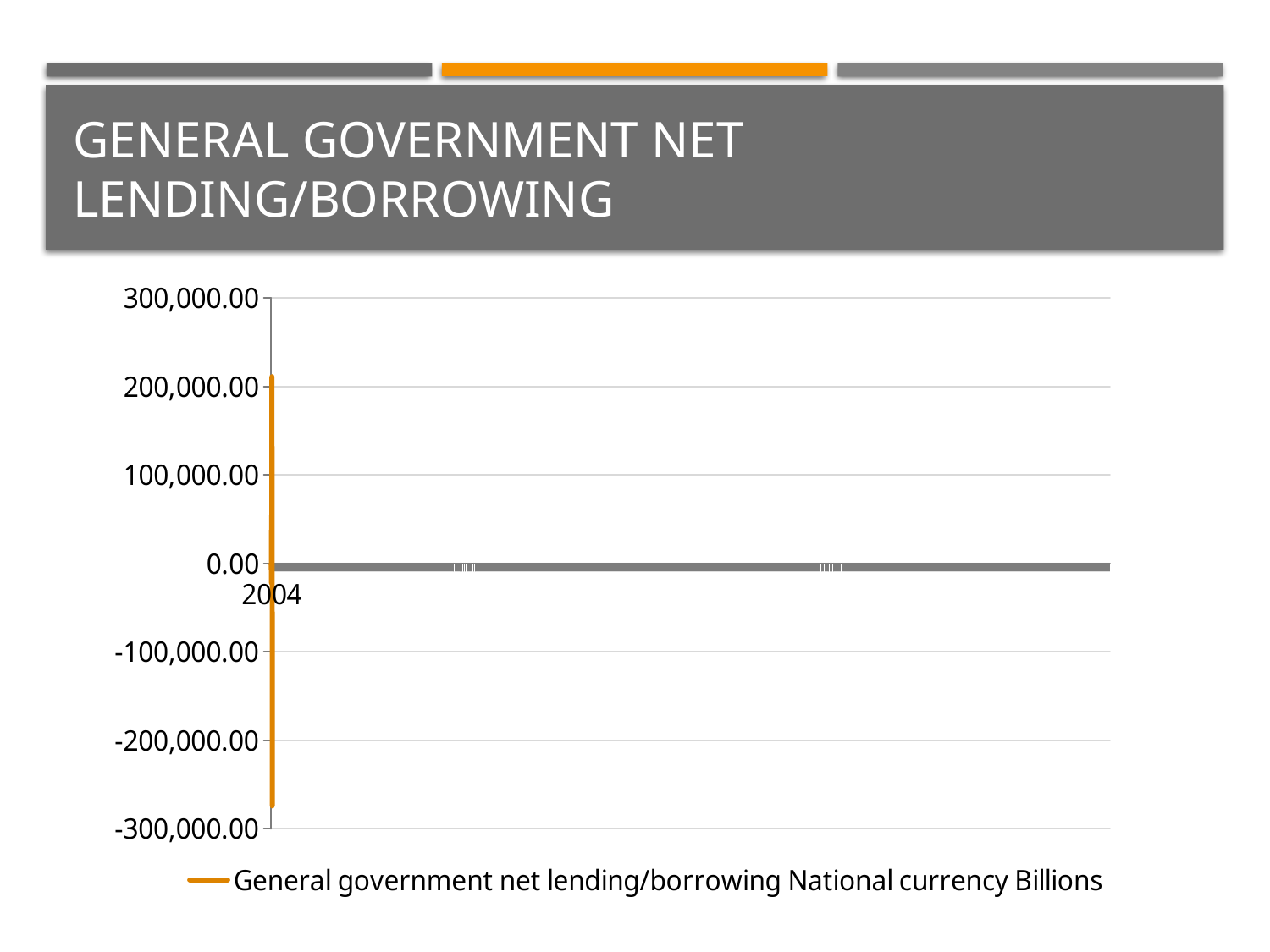
Is the lowest value reached by the series greater or less than -200,000.00? less What is the name of the series shown in the legend? General government net lending/borrowing National currency Billions What kind of chart is shown on the slide? line chart Is the highest value reached by the series greater or less than 100,000.00? greater How many series does the legend list? 1 What is the title of the chart on the slide? GENERAL GOVERNMENT NET LENDING/BORROWING